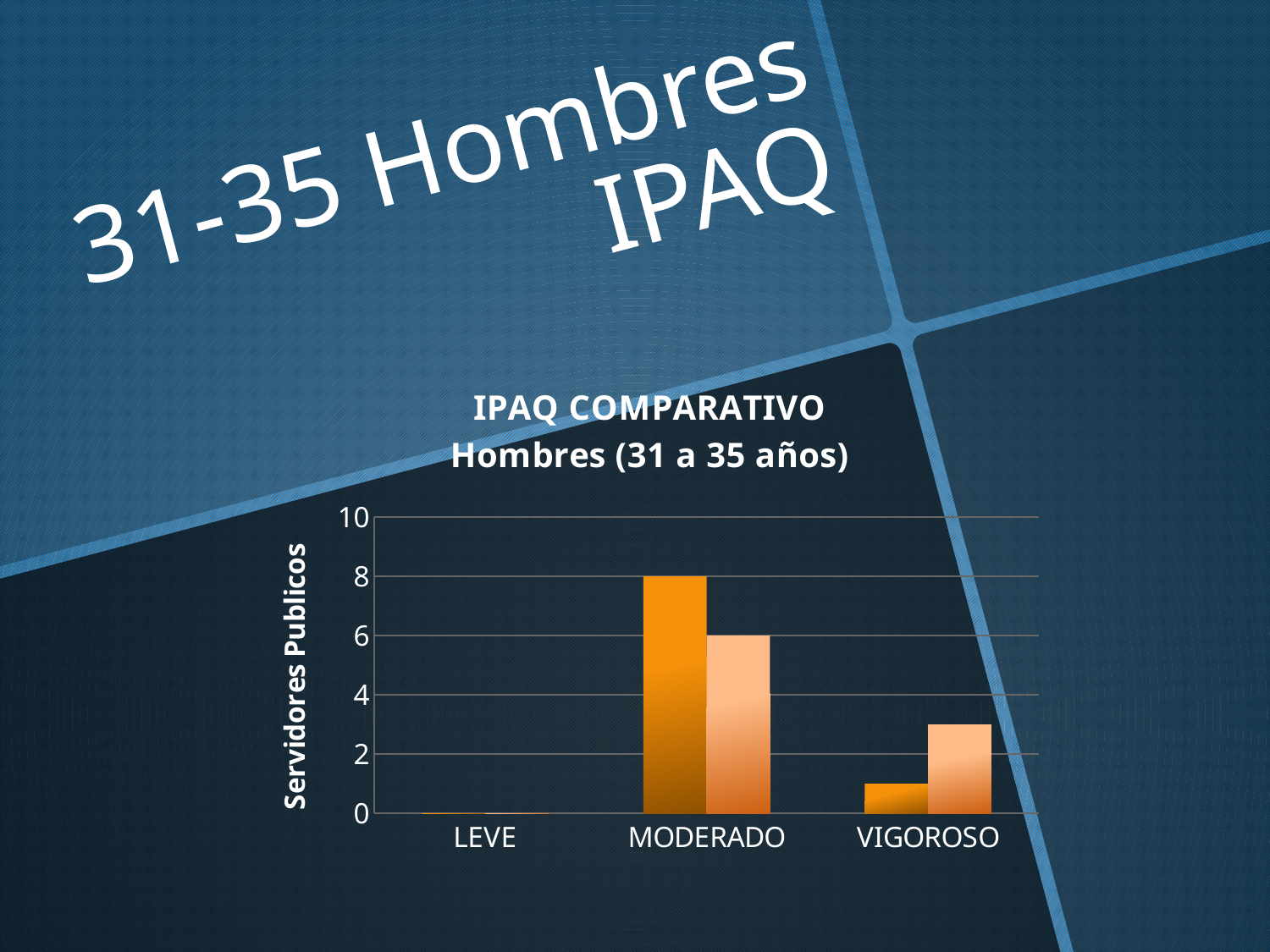
Which category has the tallest bar in the chart? MODERADO What is the title of the y axis of the chart? Servidores Publicos Which category has the lowest values in the chart? LEVE For VIGOROSO, which bar is taller, the darker orange bar or the lighter orange bar? the lighter orange bar Is the value of the darker orange bar for VIGOROSO greater or less than 2? less What is the difference between the darker orange bar and the lighter orange bar for MODERADO? 2 What is the value of the darker orange bar for MODERADO? 8 Is the value of the lighter orange bar for VIGOROSO greater or less than 2? greater How many categories are shown on the x axis of the chart? 3 What kind of chart is shown on the slide? bar chart What is the value of the lighter orange bar for MODERADO? 6 What is the title of the chart? IPAQ COMPARATIVO Hombres (31 a 35 años)